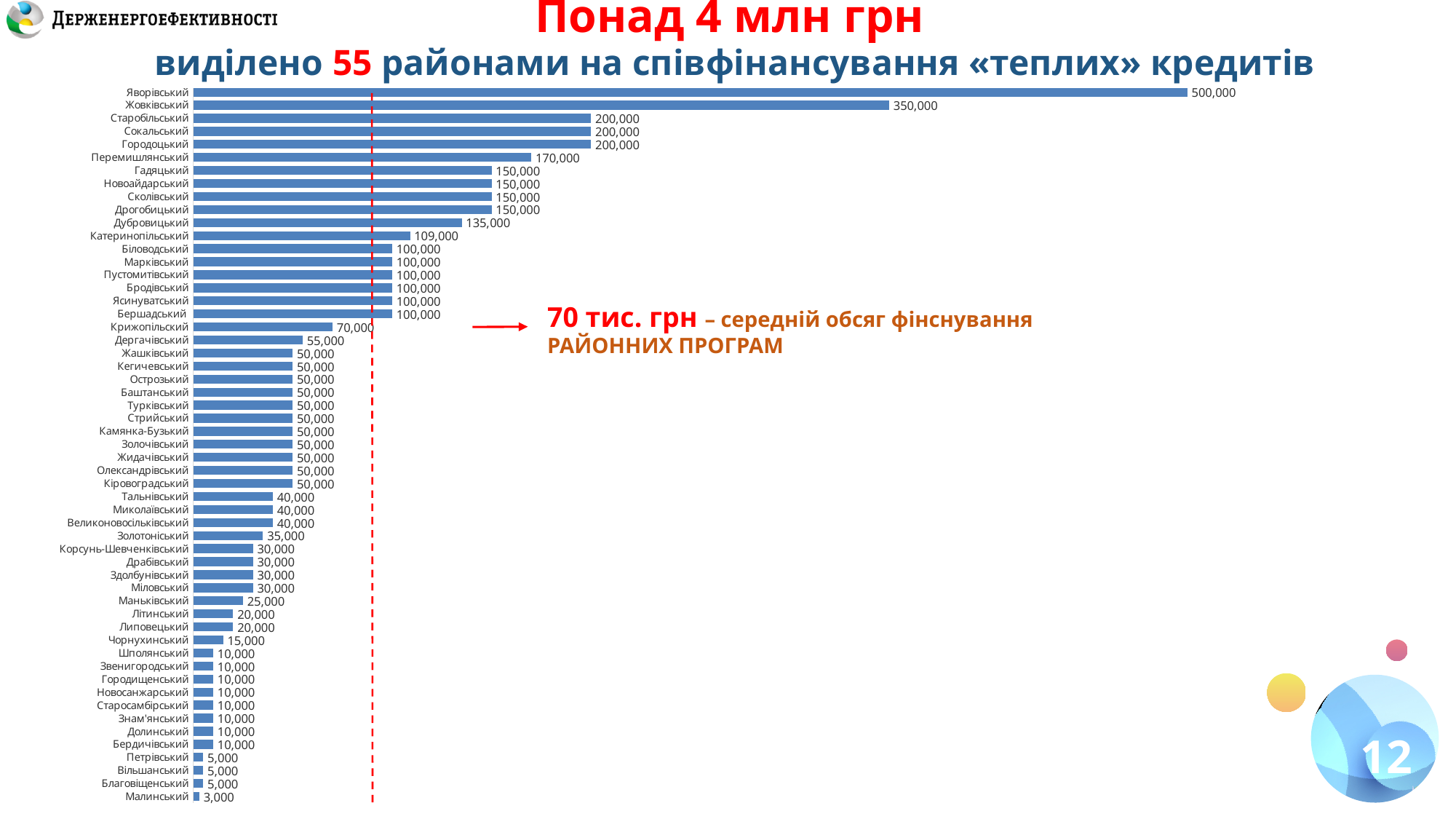
Which district has the highest value on the chart? Яворівський What value is shown for Яворівський? 500,000 What average funding amount does the red dashed line on the chart mark? 70 тис. грн How many districts are shown on the chart? 55 Which is larger, the value for Золотоніський or the value for Маньківський? Золотоніський What value is shown for Чорнухинський? 15,000 What kind of chart is shown on the slide? Bar chart What is the difference between the values for Перемишлянський and Дубровицький? 35,000 What value is shown for Катеринопільський? 109,000 What is the difference between the values for Яворівський and Жовківський? 150,000 What value is shown for Крижопільський? 70,000 Which district has the lowest value on the chart? Малинський